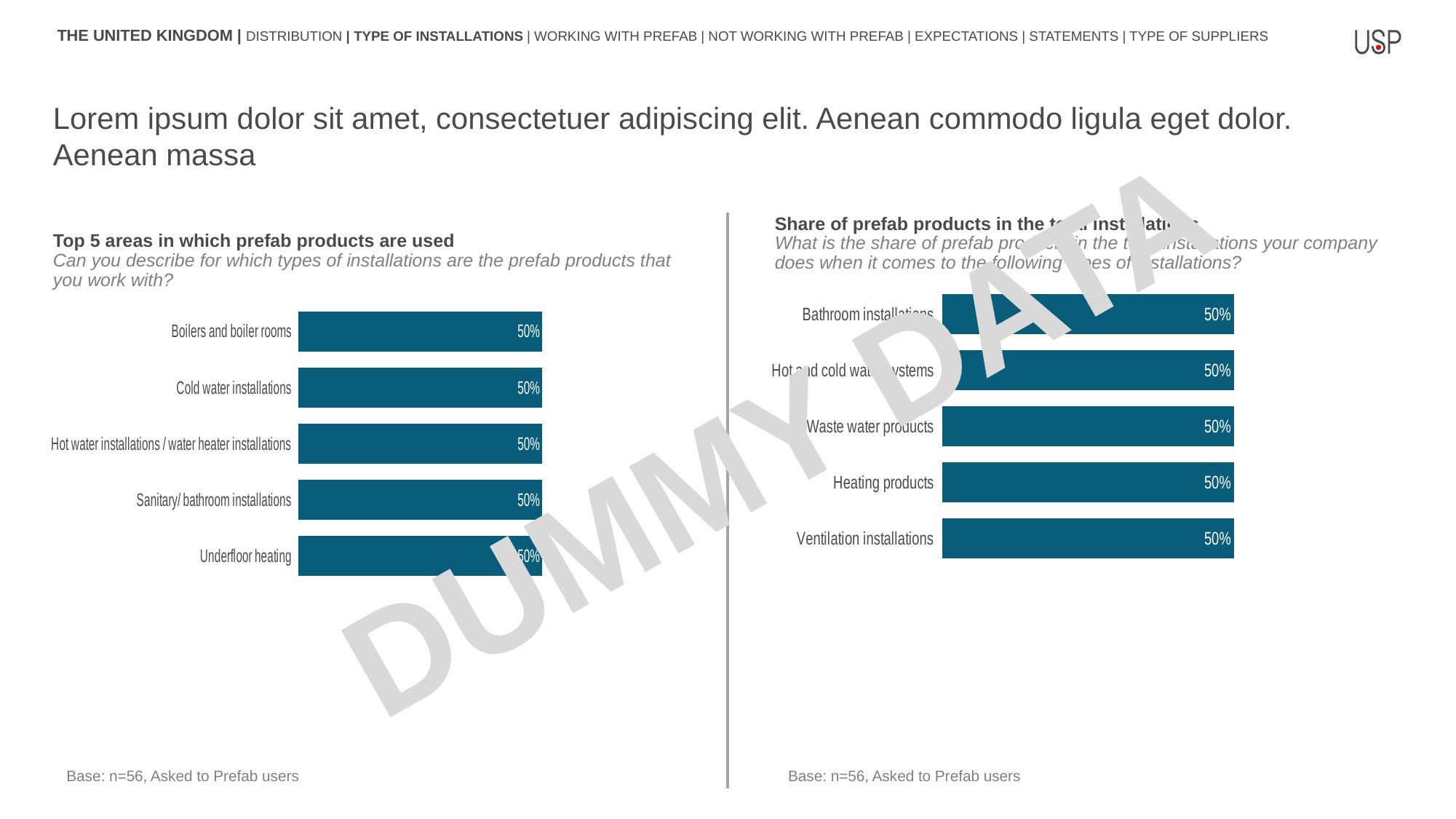
In the right chart, what is the value for Heating products? 50% How many categories are shown in the left chart, 'Top 5 areas in which prefab products are used'? 5 What kind of chart is the left chart, 'Top 5 areas in which prefab products are used'? Bar chart How many categories are shown in the right chart? 5 In the left chart, 'Top 5 areas in which prefab products are used', what is the value for Boilers and boiler rooms? 50% In the left chart, 'Top 5 areas in which prefab products are used', what is the value for Underfloor heating? 50% What base is stated below the left chart? Base: n=56, Asked to Prefab users In the left chart, what is the difference between the values for Cold water installations and Hot water installations / water heater installations? 0% What is the title of the left chart? Top 5 areas in which prefab products are used In the right chart, what is the value for Waste water products? 50% In the right chart, what is the value for Ventilation installations? 50% In the left chart, 'Top 5 areas in which prefab products are used', what is the value for Sanitary/ bathroom installations? 50%